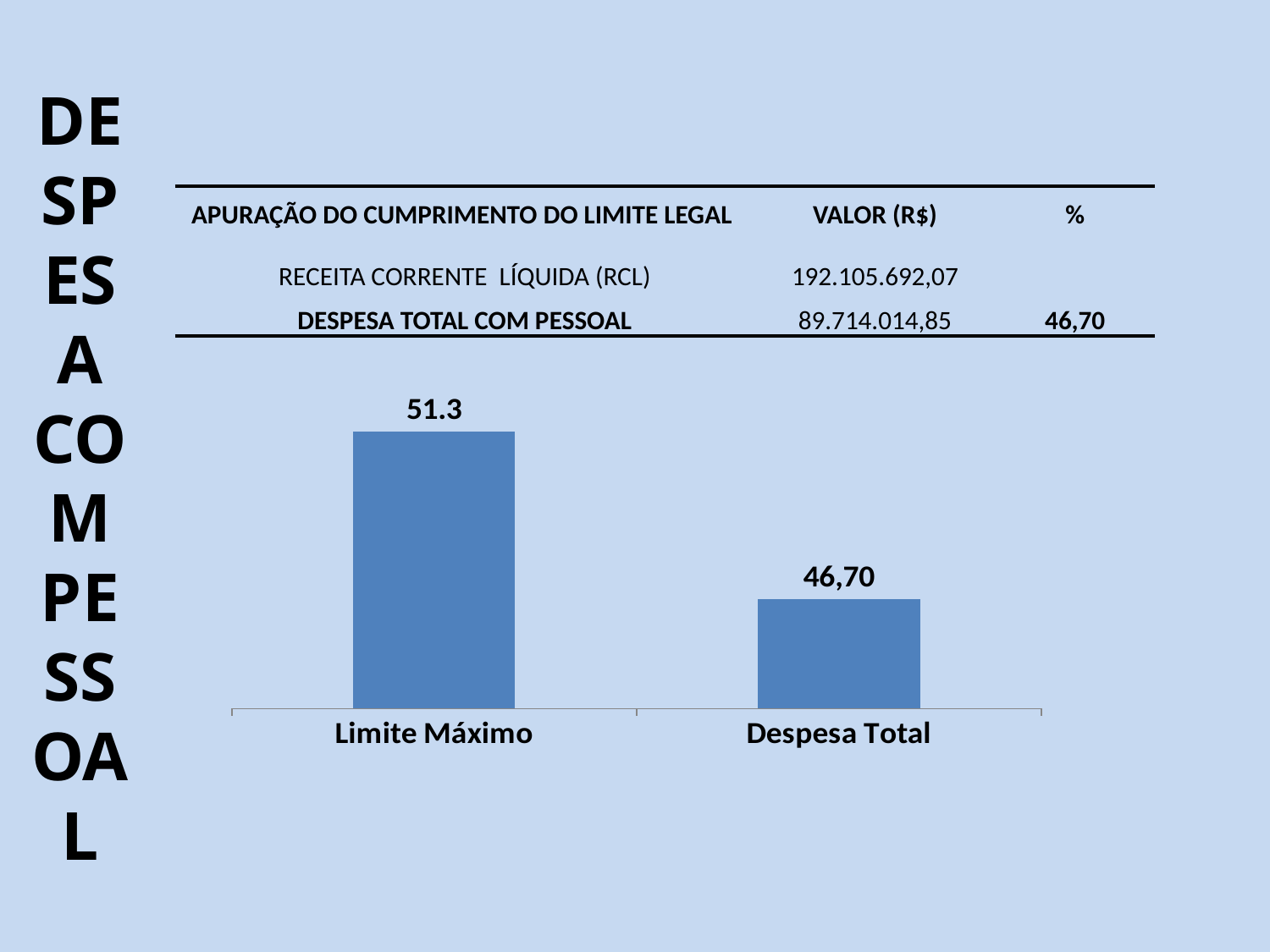
What colour are the bars in the chart? blue Which is larger, the value for Limite Máximo or the value for Despesa Total? Limite Máximo How many bars are plotted in the chart? 2 Which category has the lowest bar? Despesa Total What is the difference between the Limite Máximo value and the Despesa Total value? 4.6 What type of chart is shown on the slide? bar chart Do the values rise or fall from left to right across the categories? fall What is the value shown for Limite Máximo? 51.3 What is the value shown for Despesa Total? 46,70 What are the two category labels on the x axis of the chart? Limite Máximo, Despesa Total Which category has the highest bar? Limite Máximo